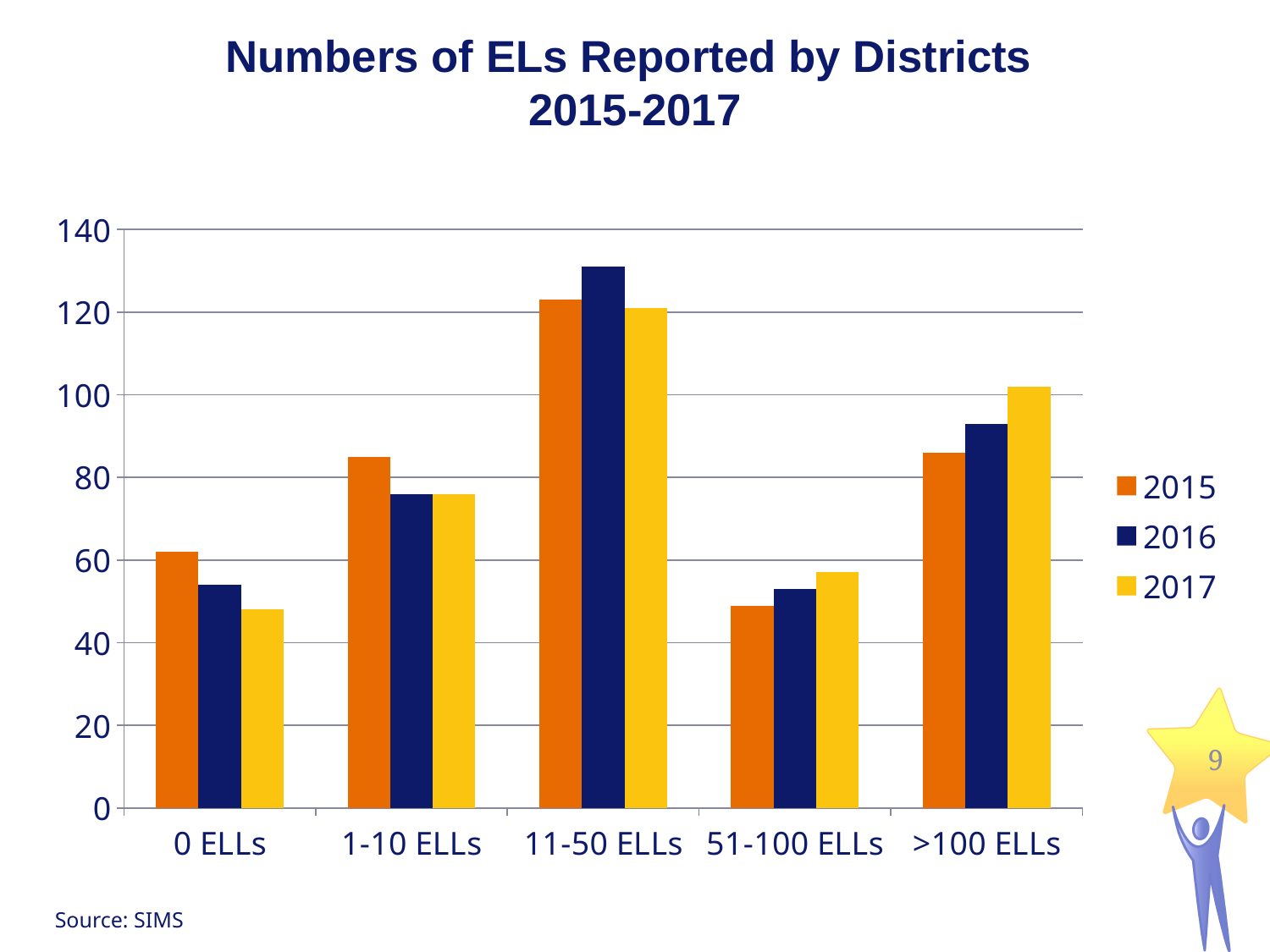
How many categories are shown on the x axis? 5 Is the value for 2015 in the 1-10 ELLs category greater or less than 80? greater Which category has the lowest value for 2017? 0 ELLs For the 0 ELLs category, do the values rise or fall from 2015 to 2017? fall What type of chart is shown on the slide? bar chart Is the value for 2016 in the >100 ELLs category greater or less than 100? less How many series does the legend list? 3 Which category has the highest value for 2016? 11-50 ELLs For the >100 ELLs category, which is larger: the 2015 value or the 2017 value? 2017 What is the title of the chart? Numbers of ELs Reported by Districts 2015-2017 Is the value for 2017 in the 0 ELLs category greater or less than 60? less